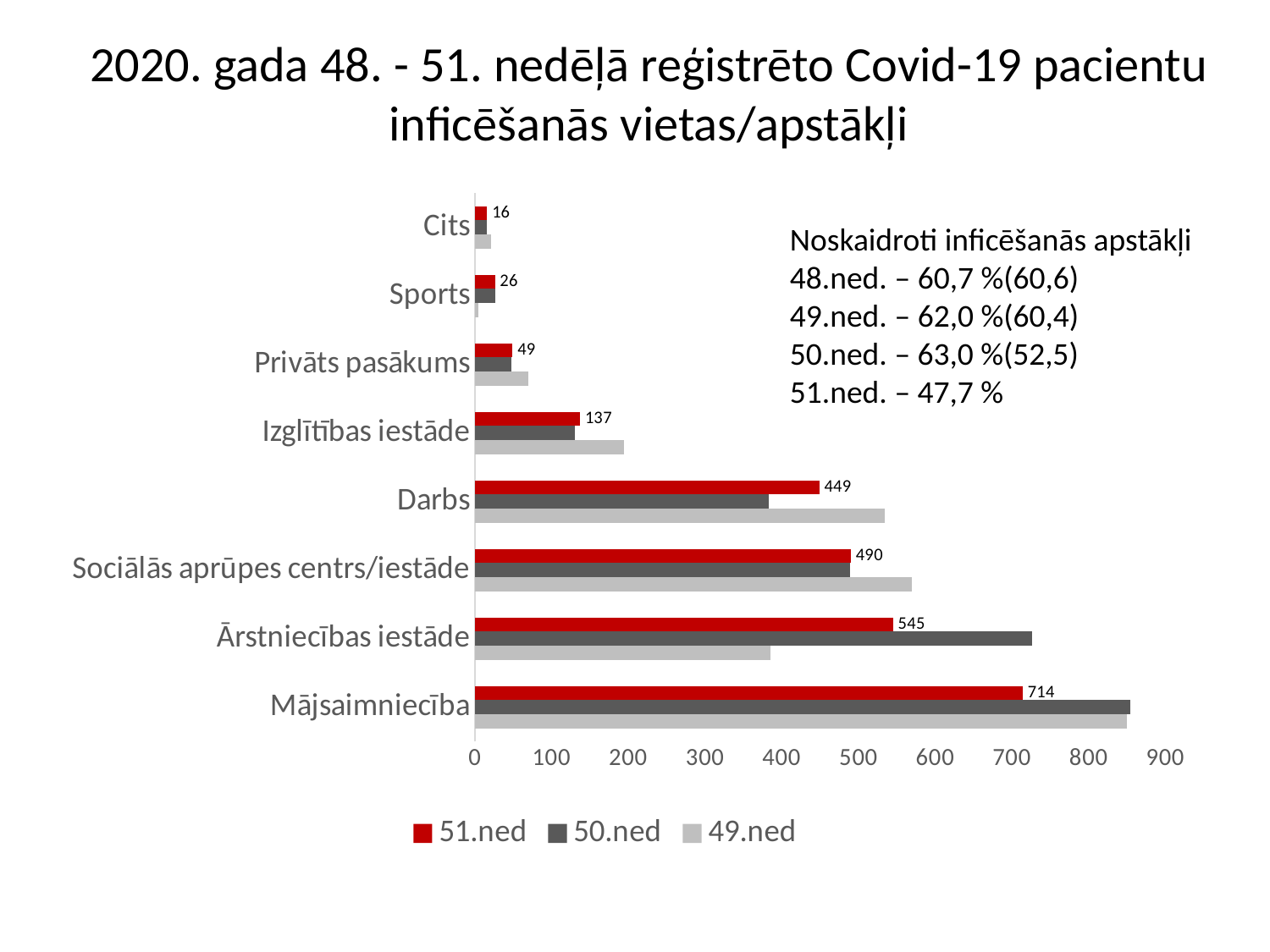
Which category has the highest 51.ned value? Mājsaimniecība How many series does the legend list? 3 Is the 50.ned value for Mājsaimniecība greater or less than 800? greater What is the 51.ned value for Sports? 26 How many categories are shown on the chart? 8 What kind of chart is shown on the slide? bar chart Which category has the lowest 51.ned value? Cits What is the difference between the 51.ned values for Ārstniecības iestāde and Sociālās aprūpes centrs/iestāde? 55 What is the 51.ned value for Darbs? 449 What is the 51.ned value for Mājsaimniecība? 714 Is the 49.ned value for Ārstniecības iestāde greater or less than 500? less For 51.ned, which is larger: Darbs or Izglītības iestāde? Darbs